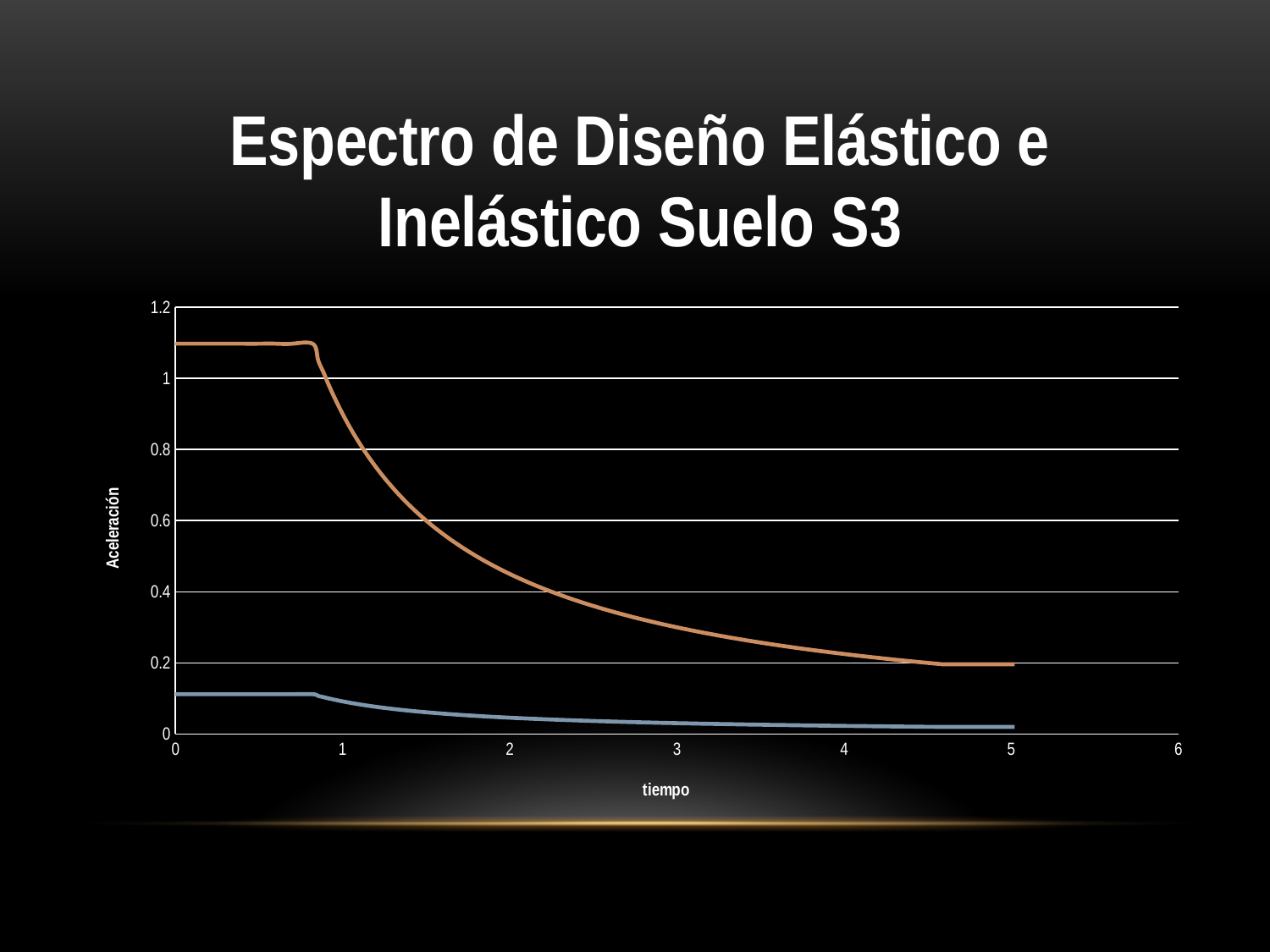
What is the label of the vertical axis? Aceleración Is the value of the orange line at tiempo 2 greater or less than 0.4? greater Is the value of the blue line at tiempo 0 greater or less than 0.2? less How many lines are plotted on the chart? 2 What kind of chart is shown on the slide? line chart Do the values of the orange line rise or fall as tiempo increases from 1 to 5? fall What is the highest value shown on the vertical axis? 1.2 Is the value of the orange line at tiempo 0 greater or less than 1? greater At tiempo 3, which line has the higher value, the orange line or the blue line? the orange line What is the title of the chart on the slide? Espectro de Diseño Elástico e Inelástico Suelo S3